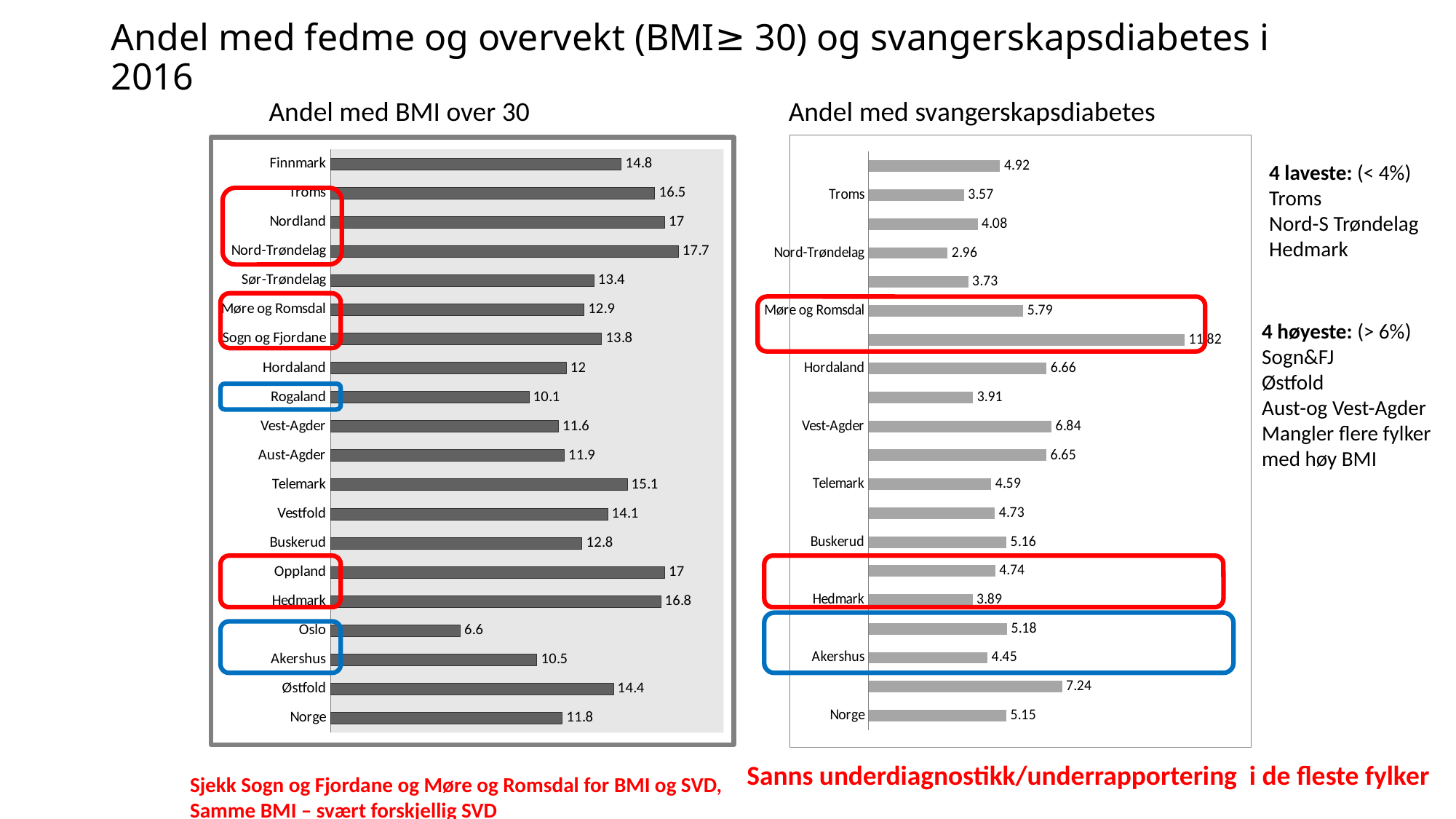
In the chart 'Andel med BMI over 30', what is the difference between the values for Hedmark and Akershus? 6.3 In the chart 'Andel med svangerskapsdiabetes', what is the value for Møre og Romsdal? 5.79 In the chart 'Andel med BMI over 30', which category has the lowest value? Oslo In the chart 'Andel med BMI over 30', which category has the highest value? Nord-Trøndelag In the chart 'Andel med BMI over 30', what is the value for Oslo? 6.6 What kind of chart is 'Andel med BMI over 30'? Bar chart In the chart 'Andel med svangerskapsdiabetes', what is the value for Norge? 5.15 In the chart 'Andel med BMI over 30', which is larger, the value for Telemark or the value for Vestfold? Telemark How many categories are shown in the chart 'Andel med BMI over 30'? 20 In the chart 'Andel med svangerskapsdiabetes', which is larger, the value for Vest-Agder or the value for Hedmark? Vest-Agder In the chart 'Andel med svangerskapsdiabetes', which category has the lowest value? Nord-Trøndelag In the chart 'Andel med BMI over 30', what is the value for Nord-Trøndelag? 17.7